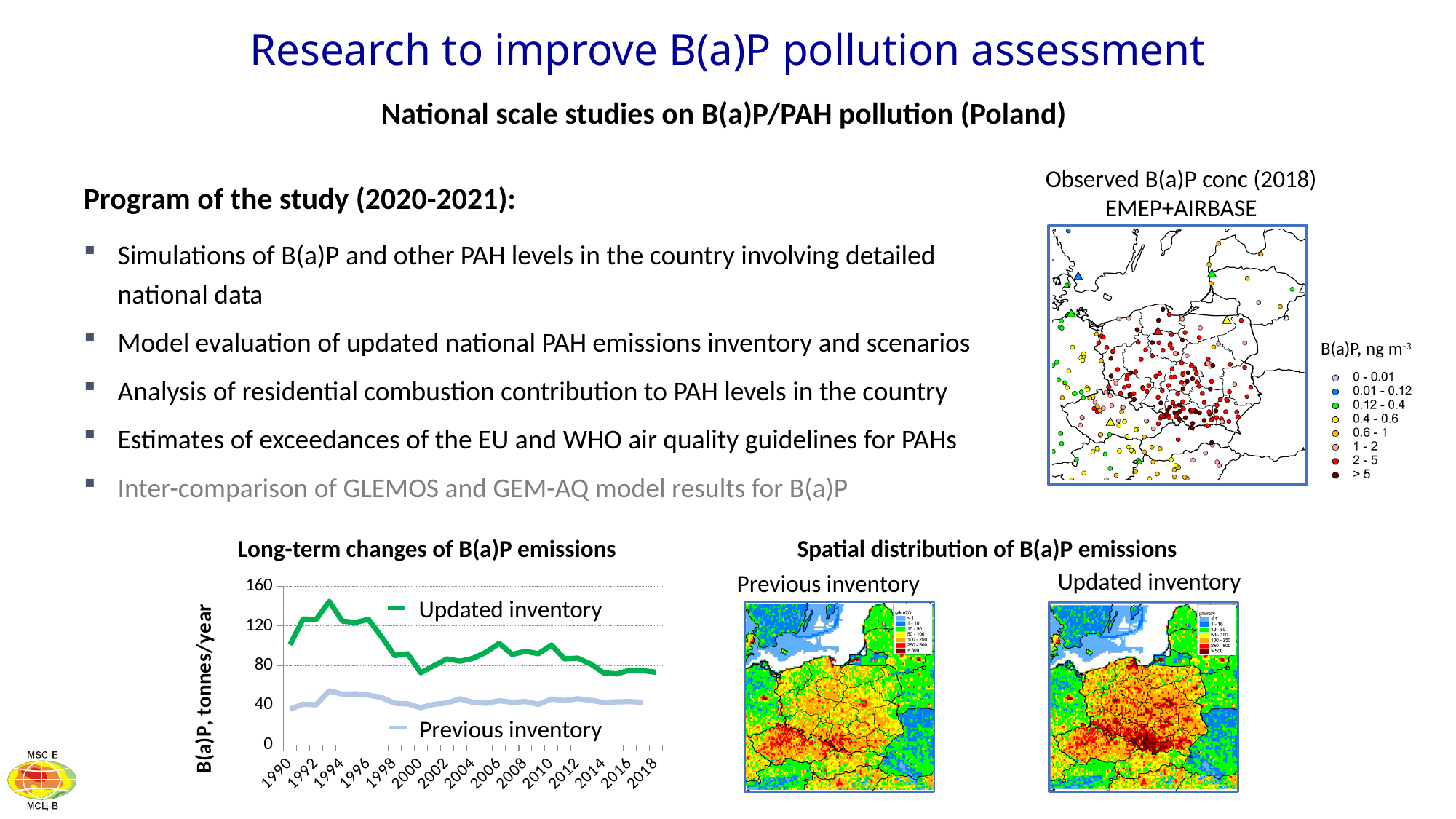
In the 'Long-term changes of B(a)P emissions' chart, is the Updated inventory value for 2018 greater or less than 80? less What kind of chart is 'Long-term changes of B(a)P emissions'? line chart In the 'Long-term changes of B(a)P emissions' chart, which series has the higher value in 2010, Updated inventory or Previous inventory? Updated inventory How many series does the legend of the 'Long-term changes of B(a)P emissions' chart list? 2 In the 'Long-term changes of B(a)P emissions' chart, is the Updated inventory value for 1994 greater or less than 120? greater In the 'Long-term changes of B(a)P emissions' chart, is the Previous inventory value for 1994 greater or less than 40? greater What is the y-axis label of the 'Long-term changes of B(a)P emissions' chart? B(a)P, tonnes/year In the 'Long-term changes of B(a)P emissions' chart, does the Updated inventory series rise or fall overall from 1990 to 2018? fall In the 'Long-term changes of B(a)P emissions' chart, what are the two series named in the legend? Updated inventory and Previous inventory In the 'Long-term changes of B(a)P emissions' chart, does the Updated inventory series rise or fall between 1994 and 2000? fall